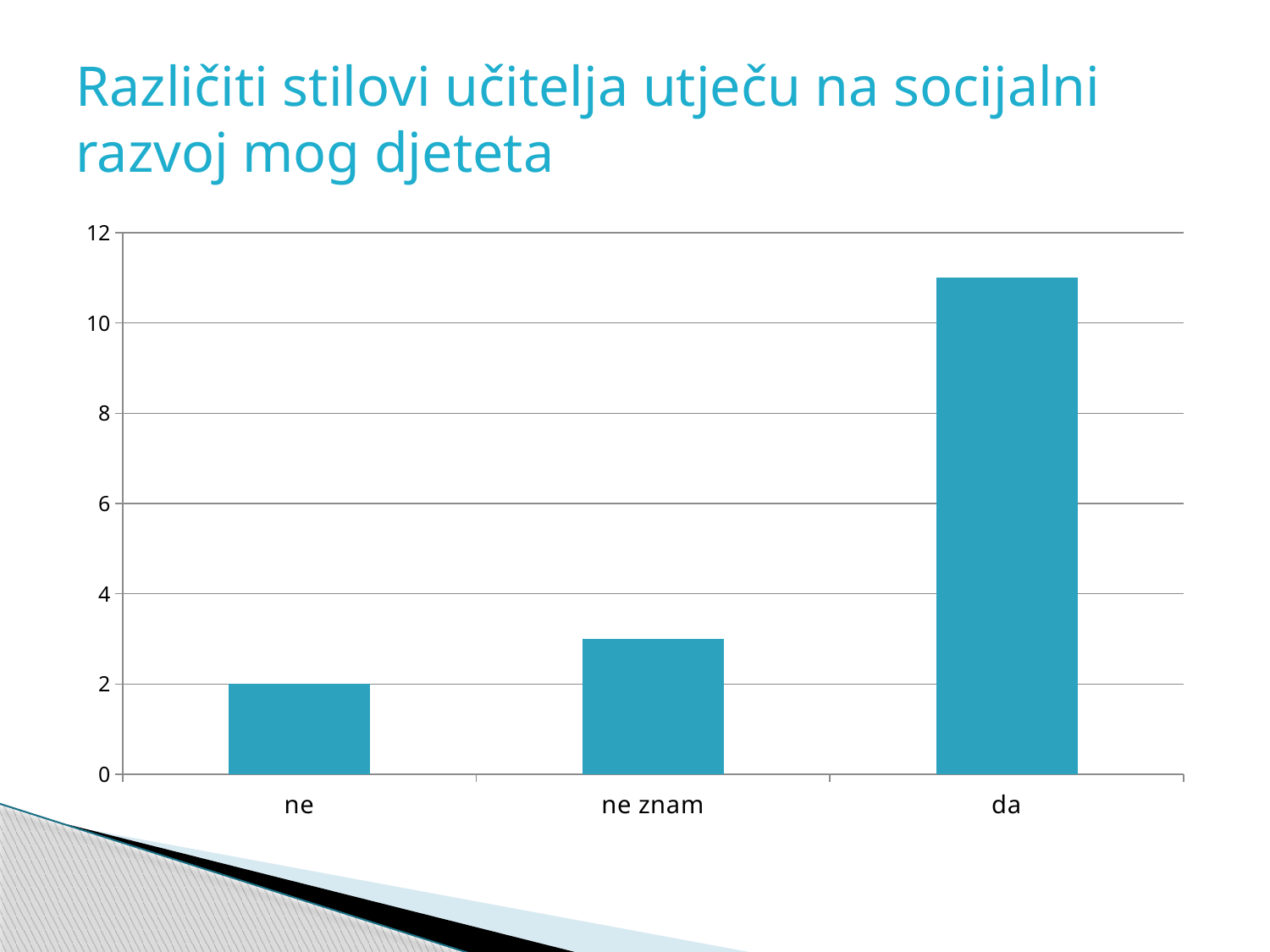
Which is larger, the value for "ne znam" or the value for "da"? da Is the value for "ne znam" greater or less than 4? less What is the value for "ne"? 2 Is the value for "da" greater or less than 12? less How many categories are shown on the x axis? 3 Which category has the highest value? da Do the values rise or fall from left to right along the x axis? rise Which category has the lowest value? ne What is the title of the slide? Različiti stilovi učitelja utječu na socijalni razvoj mog djeteta Is the value for "da" greater or less than 10? greater What kind of chart is shown on the slide? bar chart Which is larger, the value for "ne" or the value for "ne znam"? ne znam